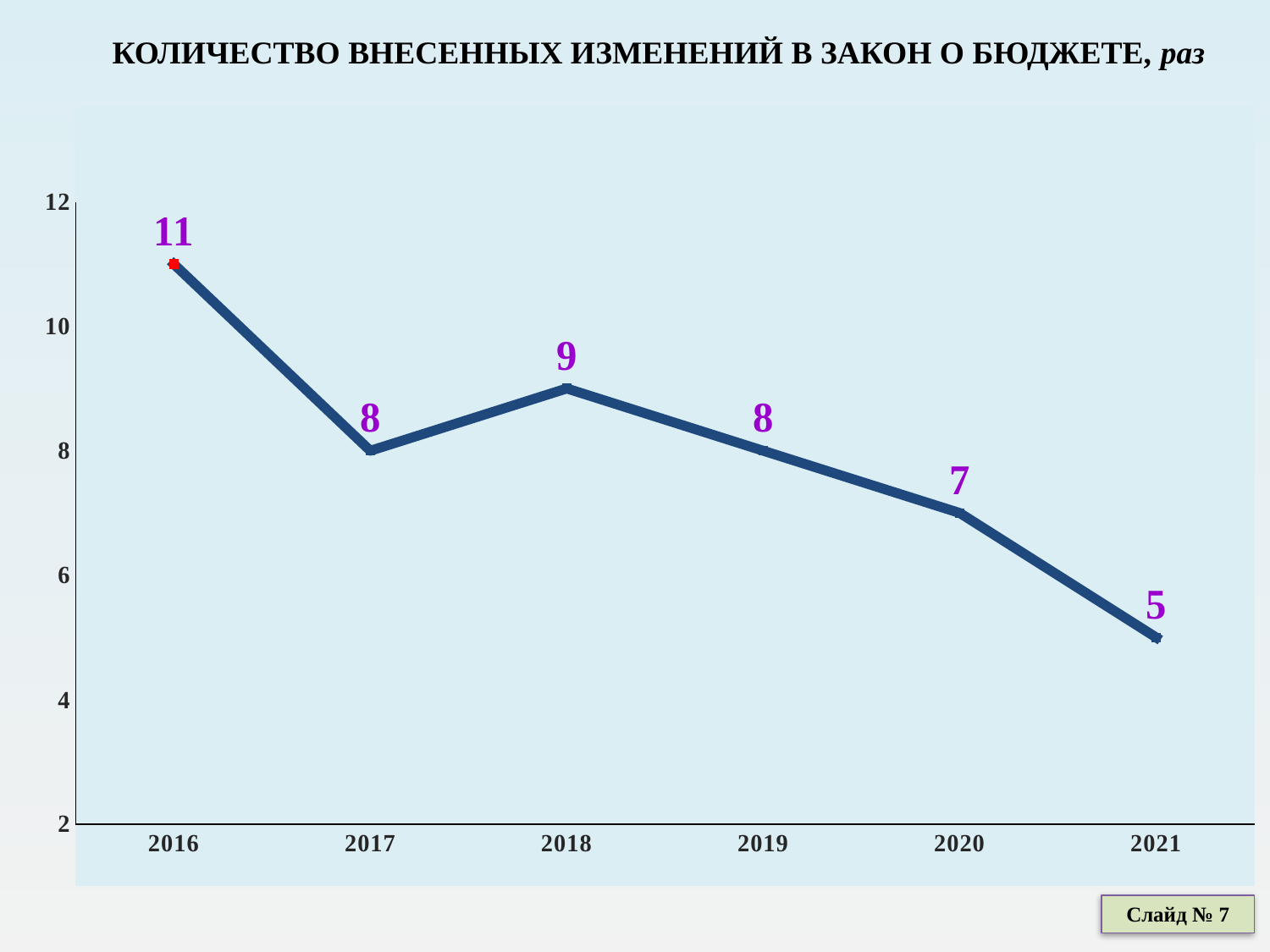
How many years are shown on the x axis? 6 What is the difference between the values for 2018 and 2020? 2 Which year has the lowest value? 2021 What is the value for 2016? 11 Which is larger, the value for 2017 or the value for 2018? 2018 What is the difference between the values for 2016 and 2021? 6 What is the value for 2018? 9 What kind of chart is this? line chart Which year has the highest value? 2016 What is the value for 2021? 5 Do the values generally rise or fall from 2016 to 2021? fall Is the value for 2020 greater or less than 6? greater